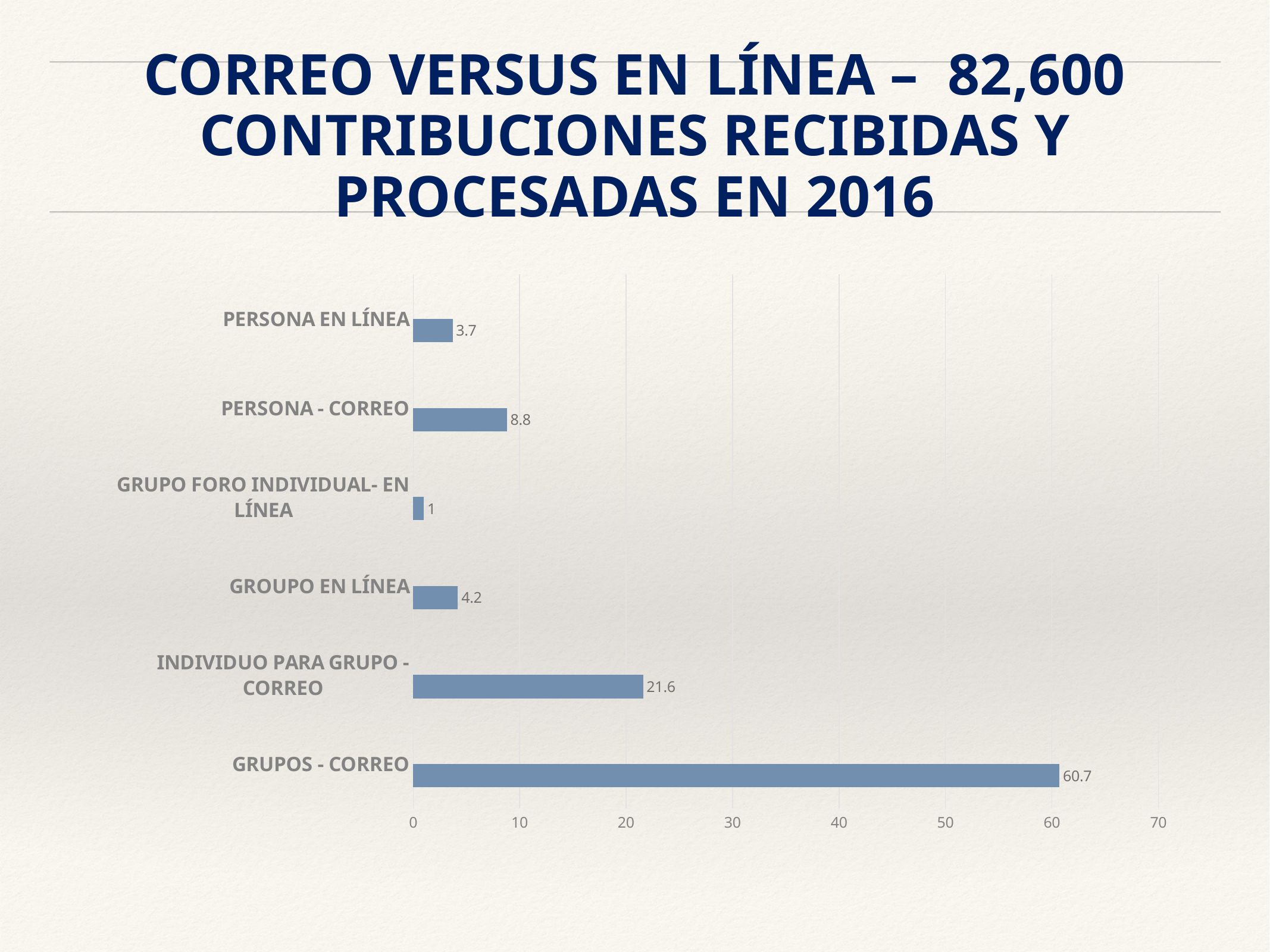
What is the value for INDIVIDUO PARA GRUPO - CORREO? 21.6 What is the value for PERSONA - CORREO? 8.8 Which is larger, the value for PERSONA - CORREO or the value for GROUPO EN LÍNEA? PERSONA - CORREO Is the value for GRUPOS - CORREO greater or less than 50? greater What kind of chart is shown on the slide? bar chart What is the value for PERSONA EN LÍNEA? 3.7 Which category has the highest value? GRUPOS - CORREO What is the value for GRUPOS - CORREO? 60.7 How many categories are shown in the chart? 6 What is the value for GRUPO FORO INDIVIDUAL- EN LÍNEA? 1 Which category has the lowest value? GRUPO FORO INDIVIDUAL- EN LÍNEA What is the difference between the values for GRUPOS - CORREO and INDIVIDUO PARA GRUPO - CORREO? 39.1